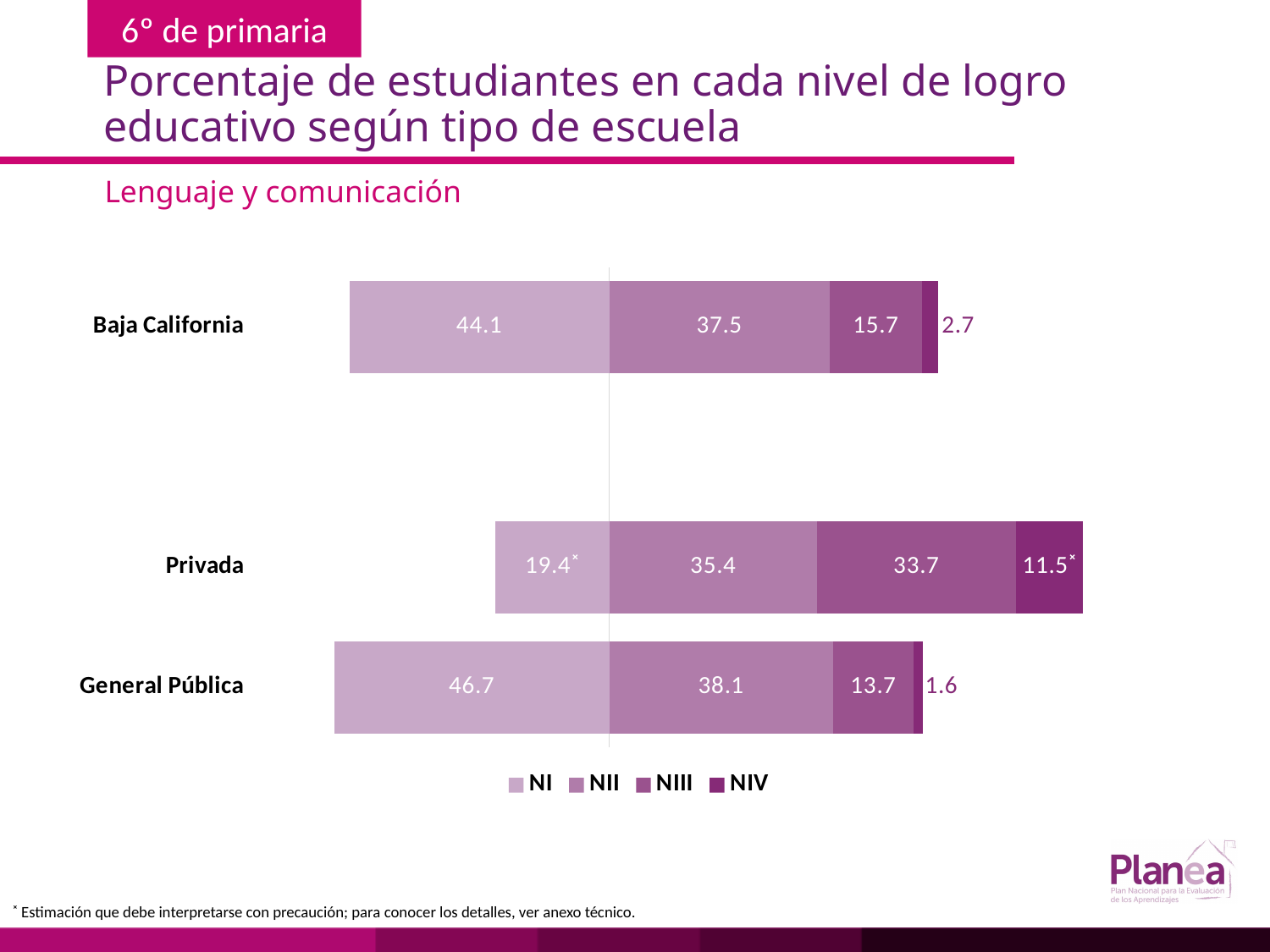
What is the NIII value for Privada? 33.7 Which category has the lowest NIV value? General Pública What kind of chart is shown on the slide? Stacked bar chart Which is larger, the NIII value for Privada or for Baja California? Privada Which school type has the highest NI value? General Pública What is the NIV value for General Pública? 1.6 What is the difference between the NI values for General Pública and Privada? 27.3 What subject is named in the subtitle above the chart? Lenguaje y comunicación How many categories are shown on the chart? 3 What is the NII value for Privada? 35.4 What is the NI value for Baja California? 44.1 How many series does the legend list? 4